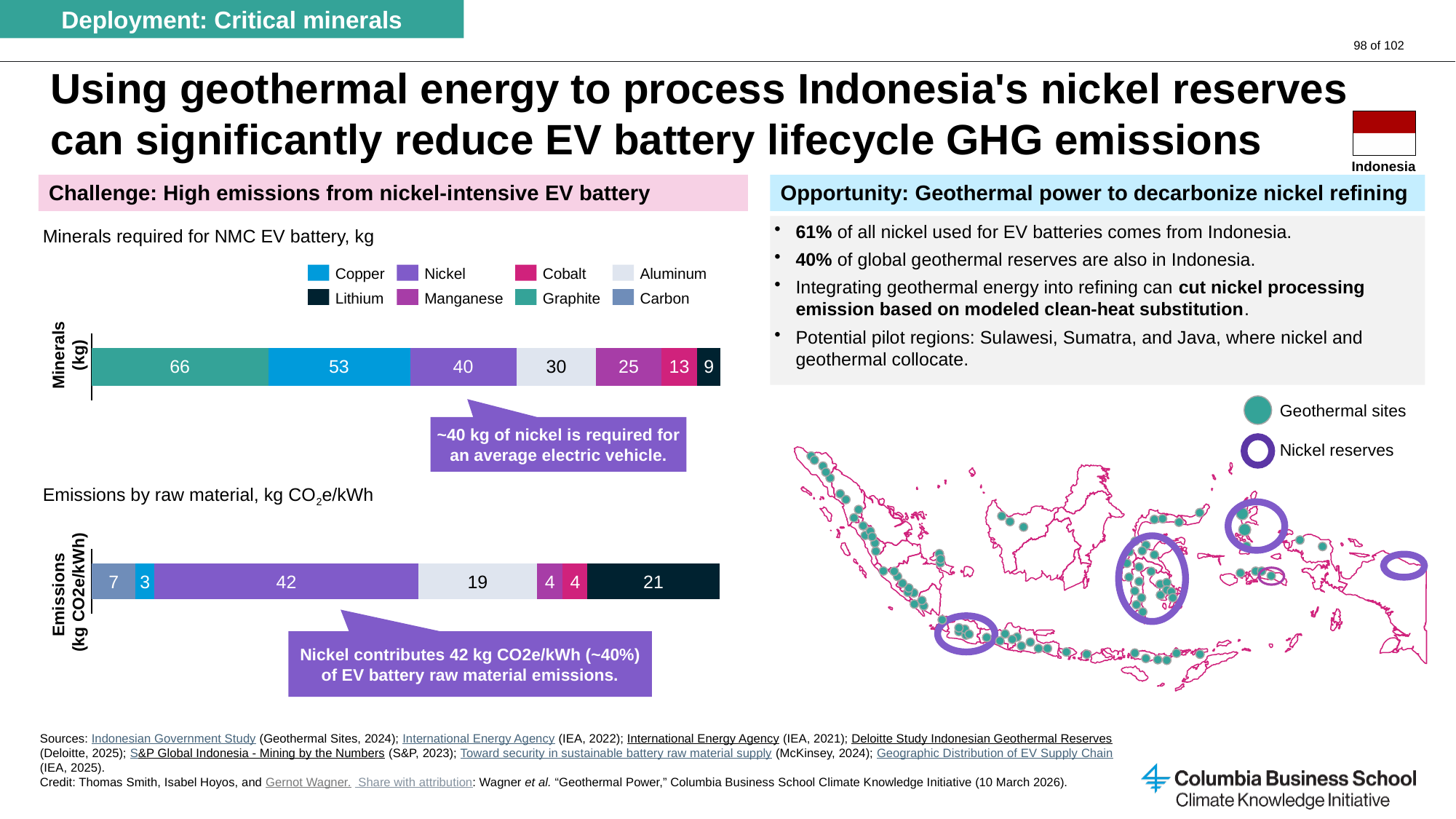
In the 'Minerals required for NMC EV battery, kg' chart, what is the total of all segments in the stacked bar? 236 In the 'Emissions by raw material, kg CO2e/kWh' chart, what is the value for lithium? 21 In the 'Minerals required for NMC EV battery, kg' chart, which mineral has the smallest value? Lithium In the 'Minerals required for NMC EV battery, kg' chart, which mineral has the largest value? Graphite In the 'Emissions by raw material, kg CO2e/kWh' chart, which material has the highest emissions? Nickel In the 'Emissions by raw material, kg CO2e/kWh' chart, what is the value for nickel? 42 In the 'Minerals required for NMC EV battery, kg' chart, what is the difference between the copper and nickel values? 13 In the 'Minerals required for NMC EV battery, kg' chart, how many kg of graphite are required? 66 In the 'Emissions by raw material, kg CO2e/kWh' chart, what is the total of all segments in the stacked bar? 100 In the 'Emissions by raw material, kg CO2e/kWh' chart, which is larger, the value for aluminum or the value for lithium? Lithium In the 'Minerals required for NMC EV battery, kg' chart, how many kg of nickel are required? 40 How many series does the legend shared by the two charts list? 8